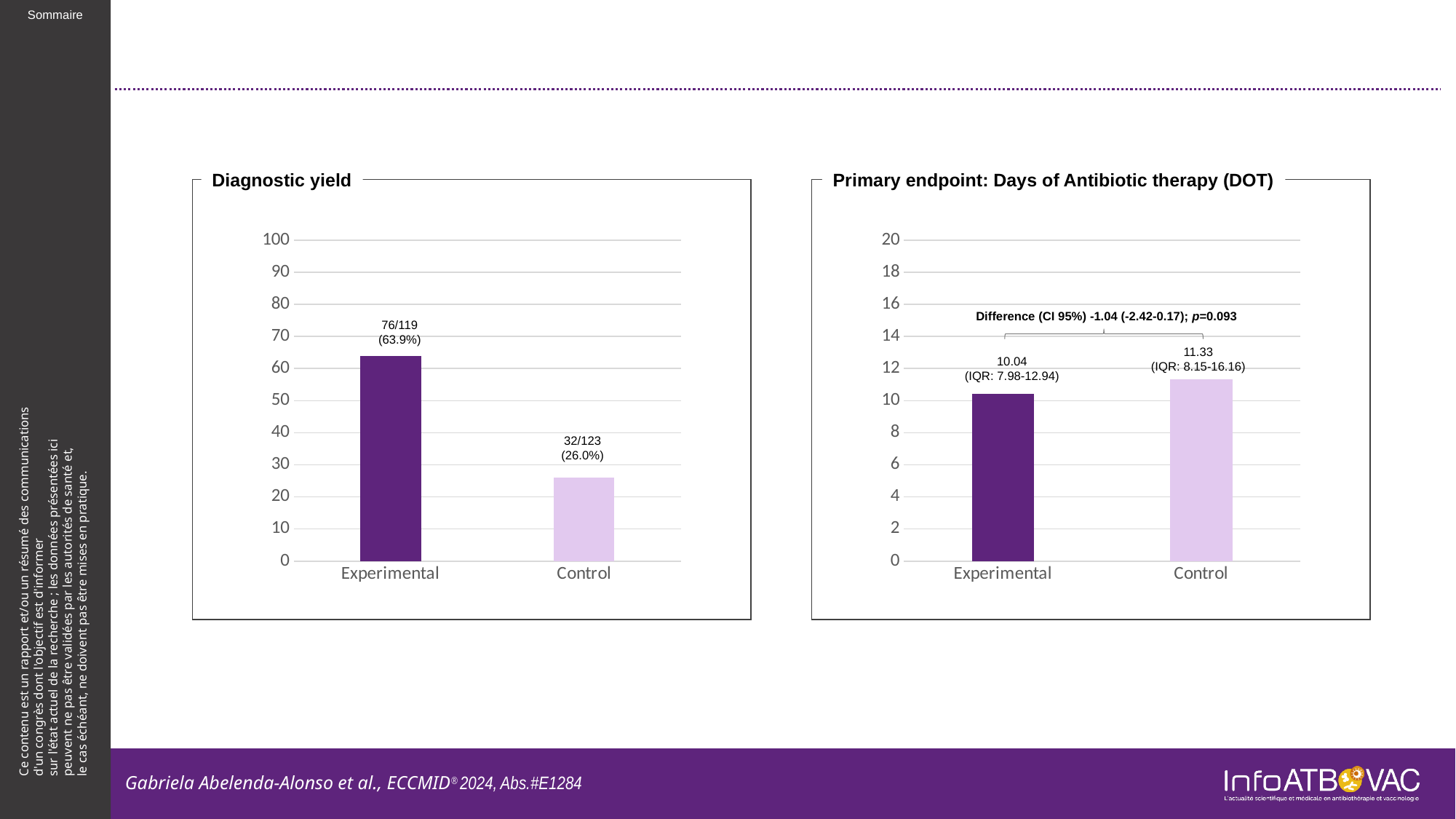
In the Diagnostic yield chart, is the value for Control greater or less than 30? less What type of chart is the Diagnostic yield chart? bar chart In the Diagnostic yield chart, how many categories are shown on the x axis? 2 In the Primary endpoint: Days of Antibiotic therapy (DOT) chart, which group has the lower number of days of antibiotic therapy? Experimental In the Diagnostic yield chart, which group has the higher diagnostic yield? Experimental In the Diagnostic yield chart, what percentage is shown for the Control group? 26.0% In the Diagnostic yield chart, what is the data label for the Experimental group? 76/119 (63.9%) In the Primary endpoint: Days of Antibiotic therapy (DOT) chart, what is the value for the Control group? 11.33 In the Primary endpoint: Days of Antibiotic therapy (DOT) chart, what is the IQR shown for the Control group? 8.15-16.16 In the Primary endpoint: Days of Antibiotic therapy (DOT) chart, what p-value is shown for the difference between groups? p=0.093 In the Primary endpoint: Days of Antibiotic therapy (DOT) chart, what is the value for the Experimental group? 10.04